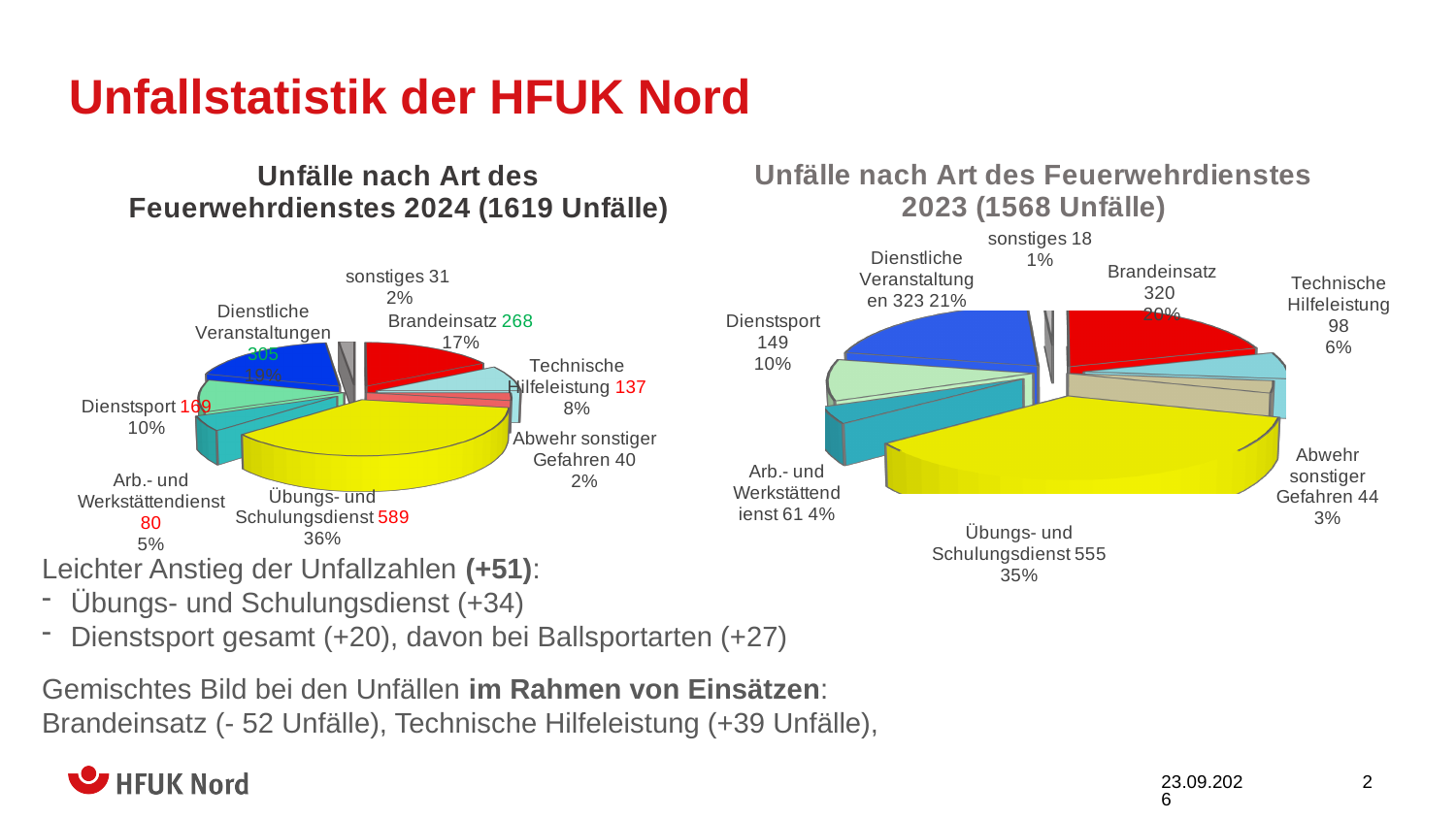
In the 2024 chart, how many accidents are attributed to Übungs- und Schulungsdienst? 589 In the 2023 chart, what share of accidents does Dienstsport account for? 10% In the 2023 chart, how many accidents are attributed to Übungs- und Schulungsdienst? 555 Which chart shows more accidents for Dienstsport, the 2024 chart or the 2023 chart? 2024 chart In the 2023 chart, which category has the smallest slice? sonstiges What is the total number of accidents stated in the title of the 2023 chart? 1568 Unfälle In the 2023 chart, what is the difference between the Brandeinsatz and Technische Hilfeleistung accident counts? 222 What kind of chart is used for 'Unfälle nach Art des Feuerwehrdienstes 2024 (1619 Unfälle)'? Pie chart In the 2024 chart, how many accidents are listed for Technische Hilfeleistung? 137 In the 2024 chart, what share of accidents does Brandeinsatz account for? 17% In the 2024 chart, which category has the largest slice? Übungs- und Schulungsdienst In the 2024 chart, how many categories are shown? 8